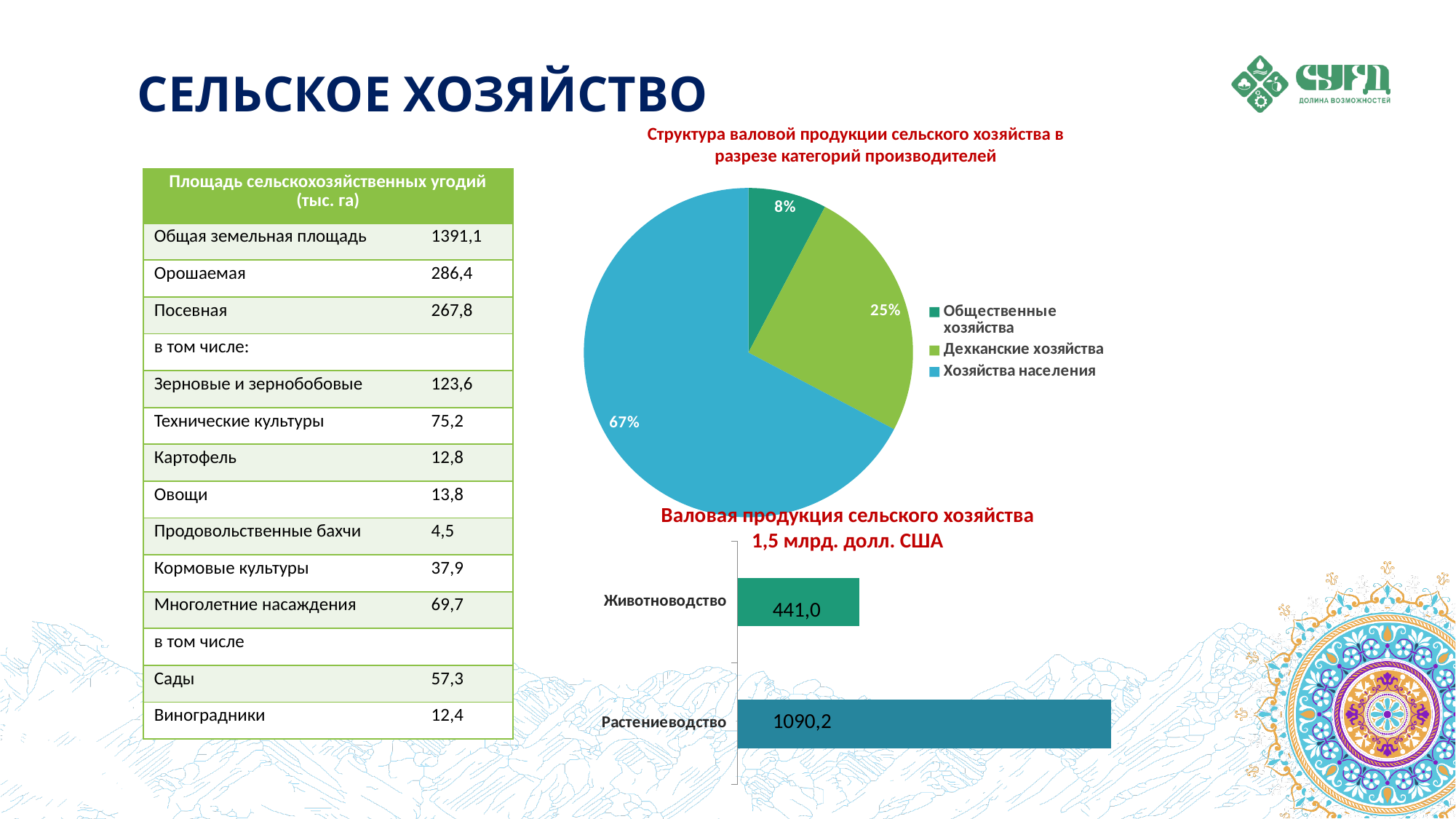
In the chart 'Валовая продукция сельского хозяйства 1,5 млрд. долл. США', what is the value for Животноводство? 441,0 In the pie chart 'Структура валовой продукции сельского хозяйства в разрезе категорий производителей', what is the difference in percentage points between Хозяйства населения and Дехканские хозяйства? 42 In the pie chart 'Структура валовой продукции сельского хозяйства в разрезе категорий производителей', what share do Хозяйства населения have? 67% In the pie chart 'Структура валовой продукции сельского хозяйства в разрезе категорий производителей', what share do Дехканские хозяйства have? 25% In the chart 'Валовая продукция сельского хозяйства 1,5 млрд. долл. США', which is larger, Животноводство or Растениеводство? Растениеводство In the pie chart 'Структура валовой продукции сельского хозяйства в разрезе категорий производителей', what share do Общественные хозяйства have? 8% In the pie chart 'Структура валовой продукции сельского хозяйства в разрезе категорий производителей', what colour is the slice for Дехканские хозяйства? Green What kind of chart is 'Валовая продукция сельского хозяйства 1,5 млрд. долл. США'? Bar chart In the pie chart 'Структура валовой продукции сельского хозяйства в разрезе категорий производителей', which category has the smallest slice? Общественные хозяйства In the chart 'Валовая продукция сельского хозяйства 1,5 млрд. долл. США', what is the value for Растениеводство? 1090,2 In the pie chart 'Структура валовой продукции сельского хозяйства в разрезе категорий производителей', how many categories does the legend list? 3 In the pie chart 'Структура валовой продукции сельского хозяйства в разрезе категорий производителей', which category has the largest slice? Хозяйства населения